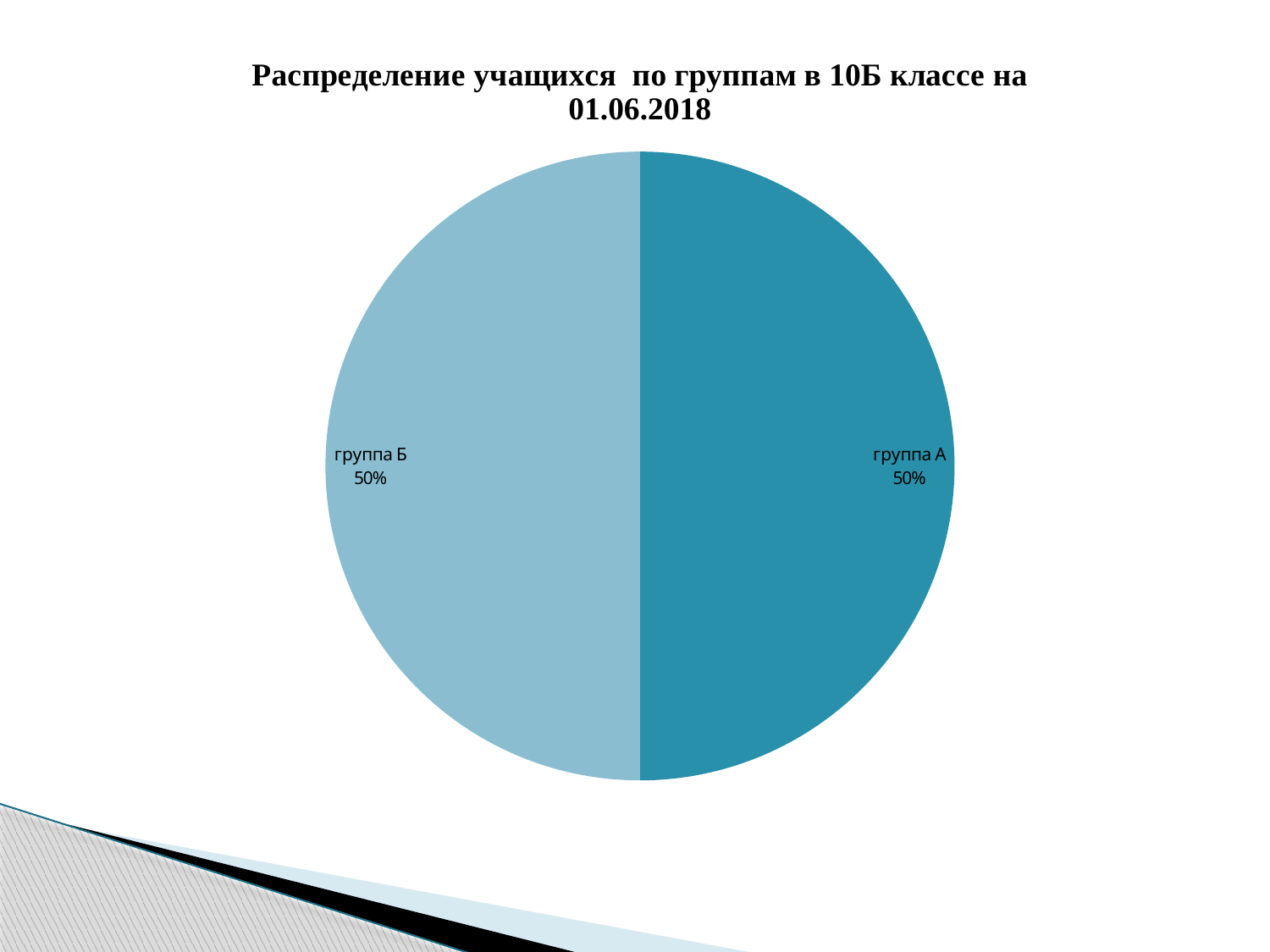
What share of the pie does группа А have? 50% What is the combined share of группа А and группа Б? 100% How many slices does the pie chart have? 2 What share of the pie does группа Б have? 50% What kind of chart is shown on the slide? pie chart What is the title of the chart? Распределение учащихся по группам в 10Б классе на 01.06.2018 Which slice is shown in the darker blue colour? группа А What is the difference between the shares of группа А and группа Б? 0%